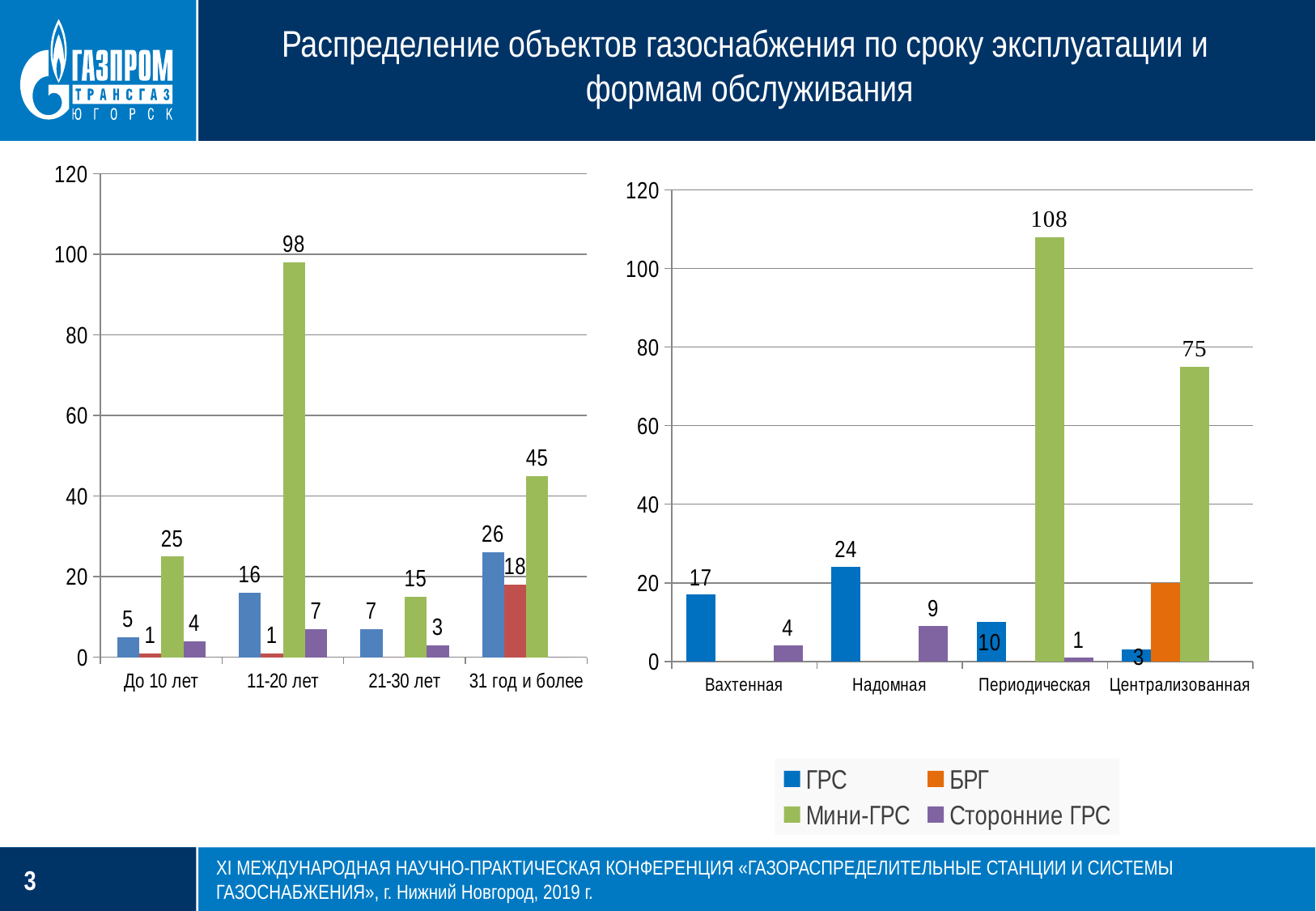
On the right chart, what is the difference between the Мини-ГРС values for Периодическая and Централизованная? 33 On the left chart, what is the value of the green bar for the category 11-20 лет? 98 On the left chart, is the blue bar for 11-20 лет larger or smaller than the blue bar for 31 год и более? smaller How many series does the legend on the slide list? 4 On the left chart, what is the value of the blue bar for the category 31 год и более? 26 On the right chart, what is the value of ГРС for Надомная? 24 What type of chart is the right chart? bar chart On the right chart, what is the value of Мини-ГРС for Периодическая? 108 On the left chart, which category has the highest green bar? 11-20 лет On the left chart, how many categories are shown on the x axis? 4 On the right chart, which category has the lowest ГРС value? Централизованная On the left chart, what is the difference between the green bar values for 11-20 лет and 31 год и более? 53